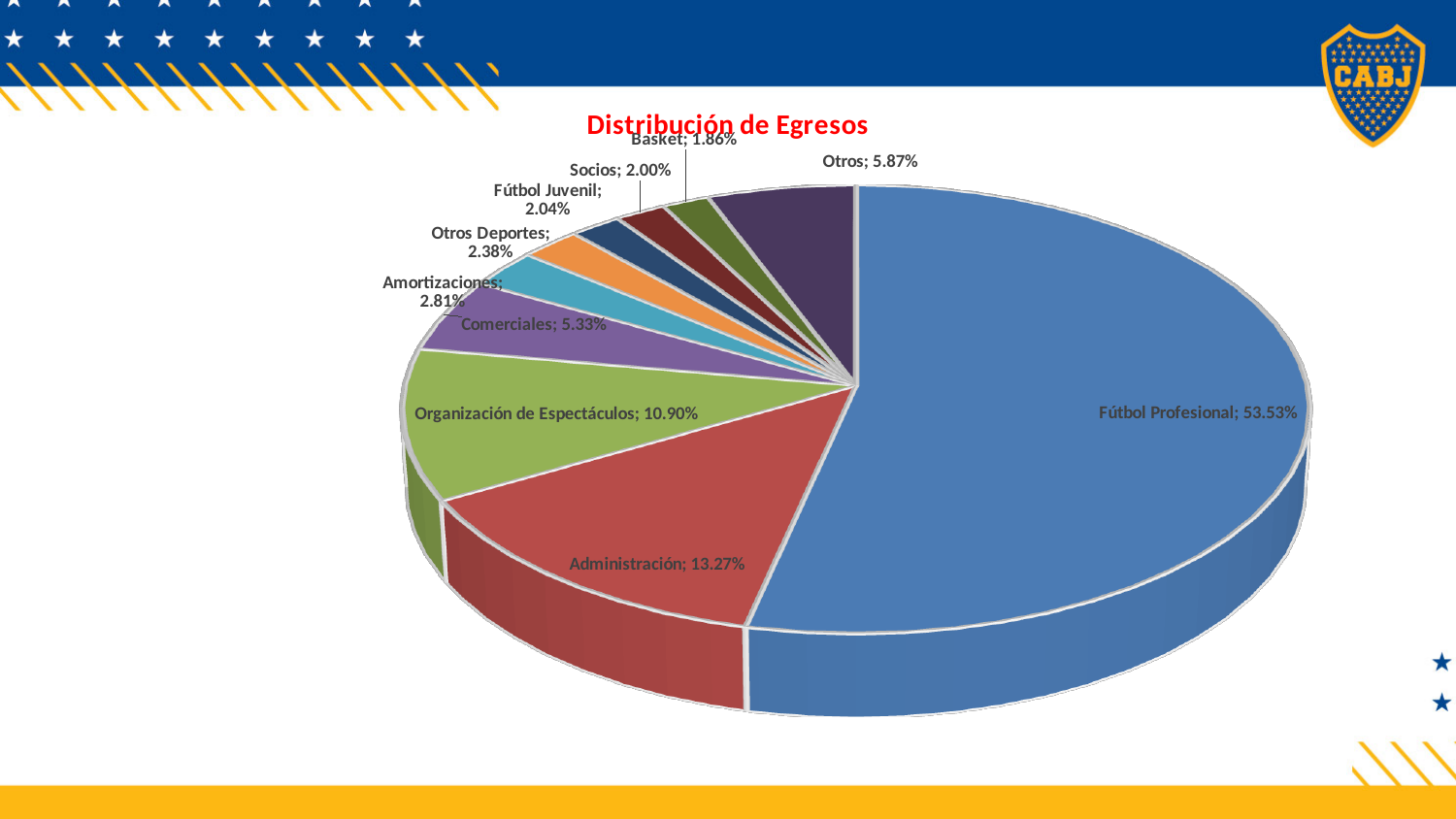
Which is larger, the share for Otros or the share for Comerciales? Otros What kind of chart is shown on the slide? pie chart Which category has the largest slice of the pie? Fútbol Profesional What is the value shown for Administración? 13.27% What is the value shown for Comerciales? 5.33% How many slices does the pie chart have? 10 What is the difference between the Administración and Organización de Espectáculos shares? 2.37% What is the title of the chart? Distribución de Egresos What is the value shown for Organización de Espectáculos? 10.90% What is the value shown for Basket? 1.86% What share of the pie does Fútbol Profesional represent? 53.53% Which category has the smallest slice of the pie? Basket